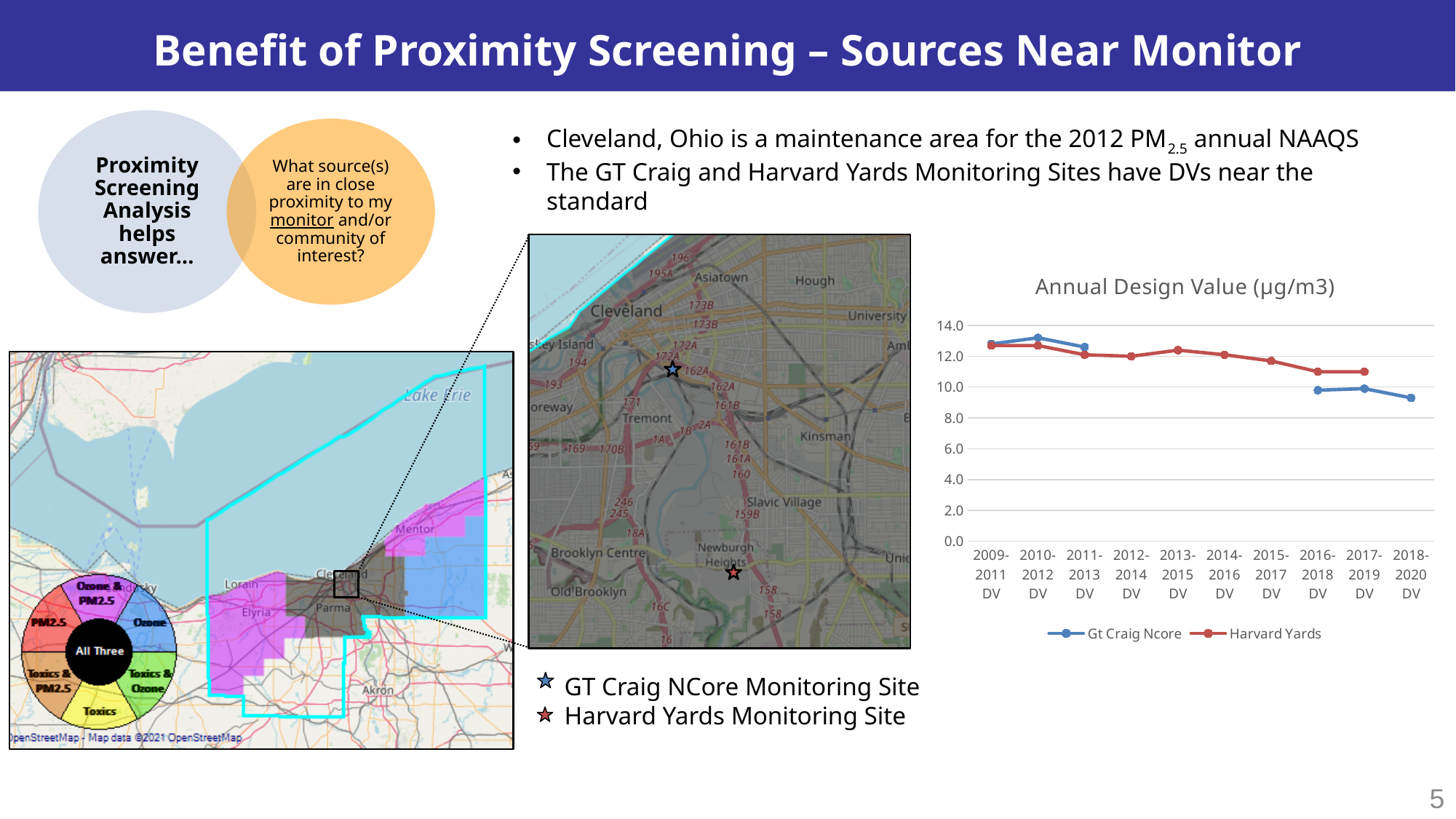
What kind of chart is the Annual Design Value chart? line chart How many design-value periods are shown on the x axis of the Annual Design Value chart? 10 In the Annual Design Value chart, is the Gt Craig Ncore value for 2010-2012 DV greater or less than 12.0? greater In the Annual Design Value chart, for which period is the Gt Craig Ncore value highest? 2010-2012 DV In the Annual Design Value chart, which series has the higher value for 2016-2018 DV? Harvard Yards In the Annual Design Value chart, which series has the higher value for 2010-2012 DV? Gt Craig Ncore In the Annual Design Value chart, is the Gt Craig Ncore value for 2018-2020 DV greater or less than 10.0? less What unit is given in the title of the line chart? µg/m3 In the Annual Design Value chart, is the Harvard Yards value for 2016-2018 DV greater or less than 12.0? less How many series does the legend of the Annual Design Value chart list? 2 In the Annual Design Value chart, do the Gt Craig Ncore values generally rise or fall from 2009-2011 DV to 2018-2020 DV? fall